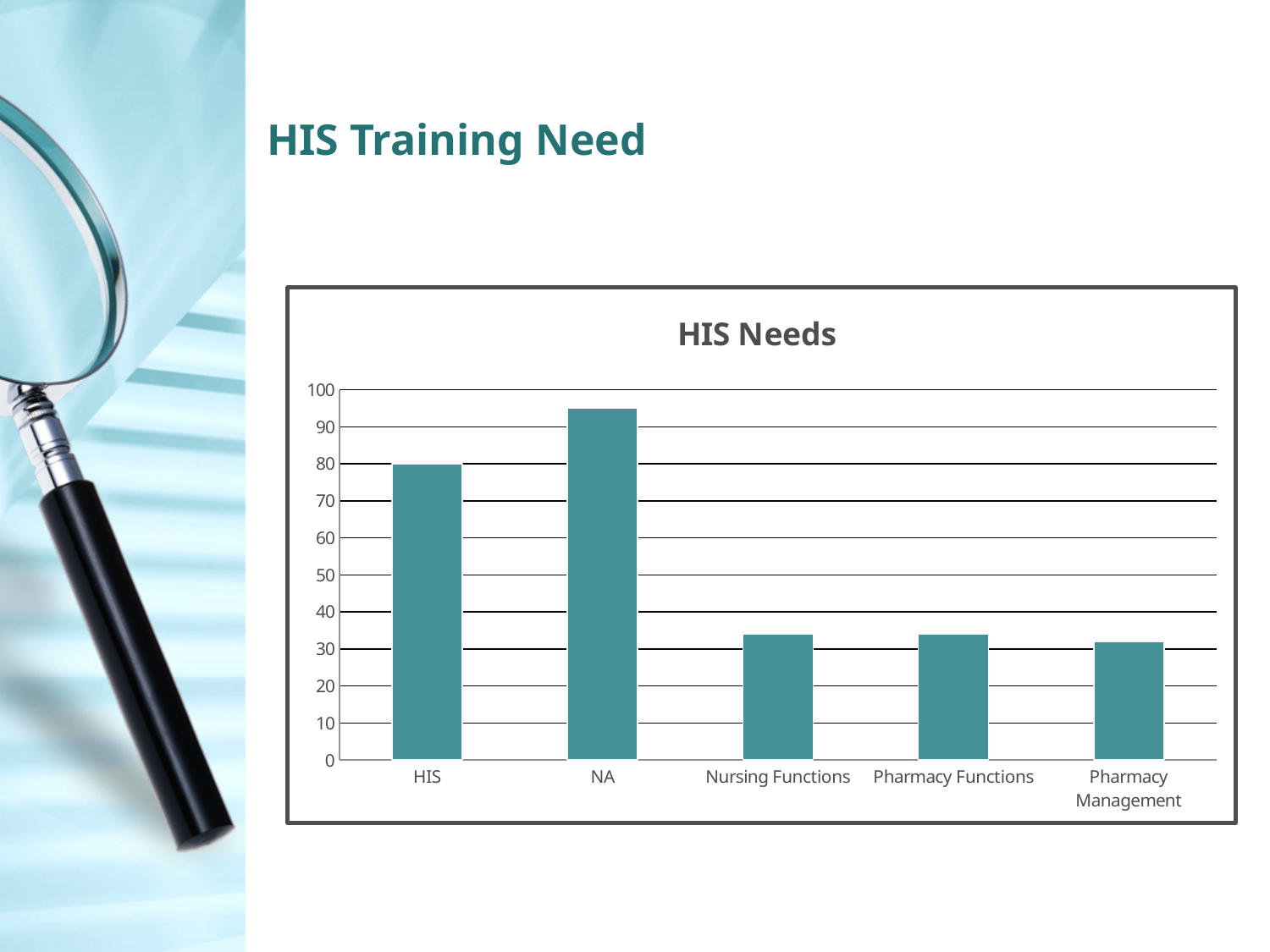
Is the value for Nursing Functions greater or less than 40? less Which is larger, the value for HIS or the value for NA? NA Which is larger, the value for HIS or the value for Nursing Functions? HIS Is the value for NA greater or less than 90? greater Is the value for Pharmacy Functions greater or less than 50? less What is the title of the chart? HIS Needs What kind of chart is shown on the slide? bar chart Which category has the highest value in the chart? NA What is the highest value shown on the y axis of the chart? 100 How many categories are shown on the x axis of the chart? 5